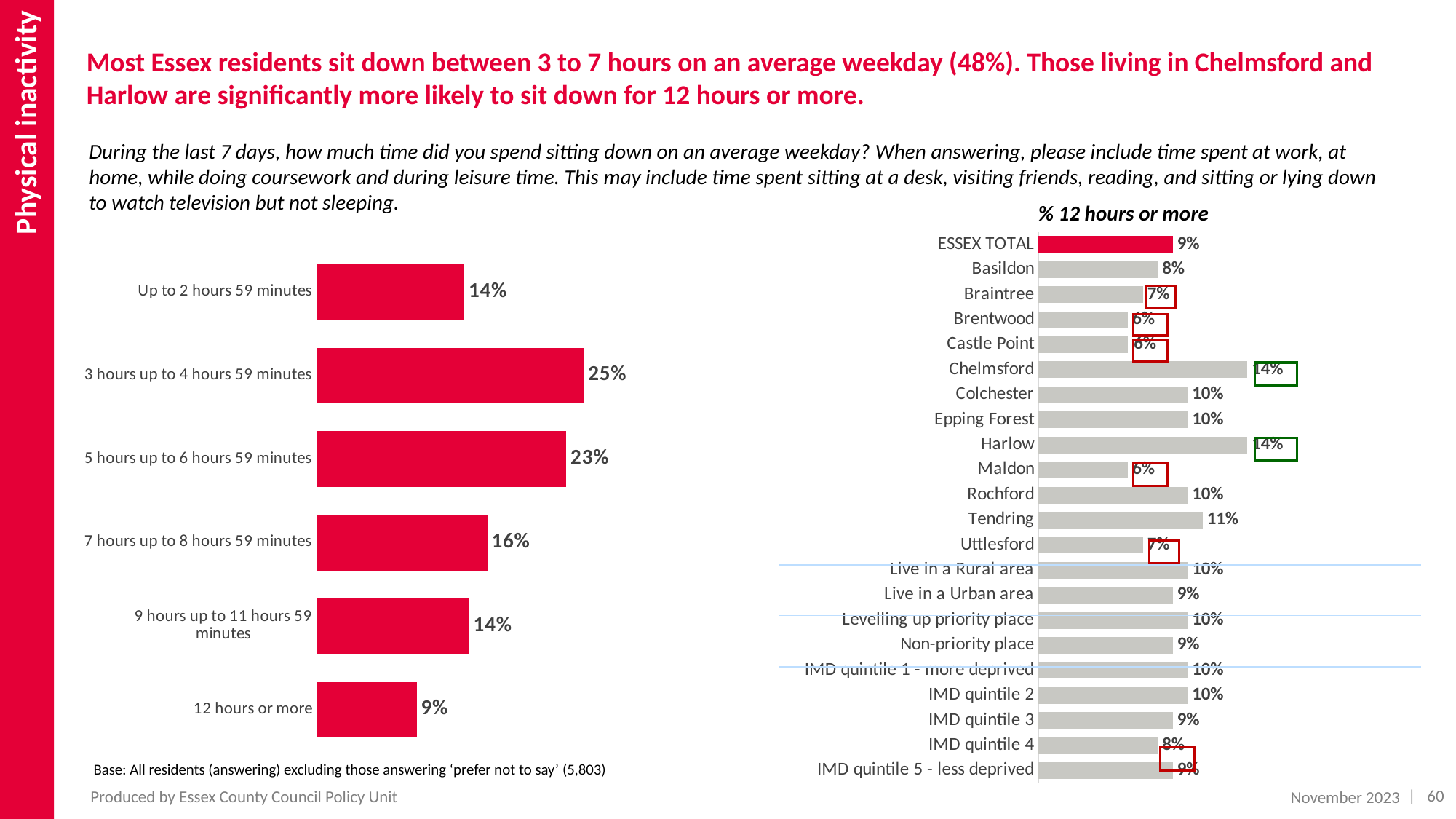
On the left chart, what percentage of residents sit down for 3 hours up to 4 hours 59 minutes? 25% On the left chart, what percentage of residents sit down for 12 hours or more? 9% On the '% 12 hours or more' chart, what is the value for Tendring? 11% What is the title of the right-hand chart? % 12 hours or more What kind of chart is the left chart? Bar chart On the left chart, which category has the highest percentage? 3 hours up to 4 hours 59 minutes On the '% 12 hours or more' chart, what is the value for ESSEX TOTAL? 9% How many categories are shown on the left chart? 6 On the '% 12 hours or more' chart, what is the difference between the value for Harlow and the value for Maldon? 8% On the left chart, which category has the lowest percentage? 12 hours or more On the left chart, what is the difference between the percentage for 5 hours up to 6 hours 59 minutes and the percentage for 7 hours up to 8 hours 59 minutes? 7% On the '% 12 hours or more' chart, which is larger, the value for Chelmsford or the value for Basildon? Chelmsford